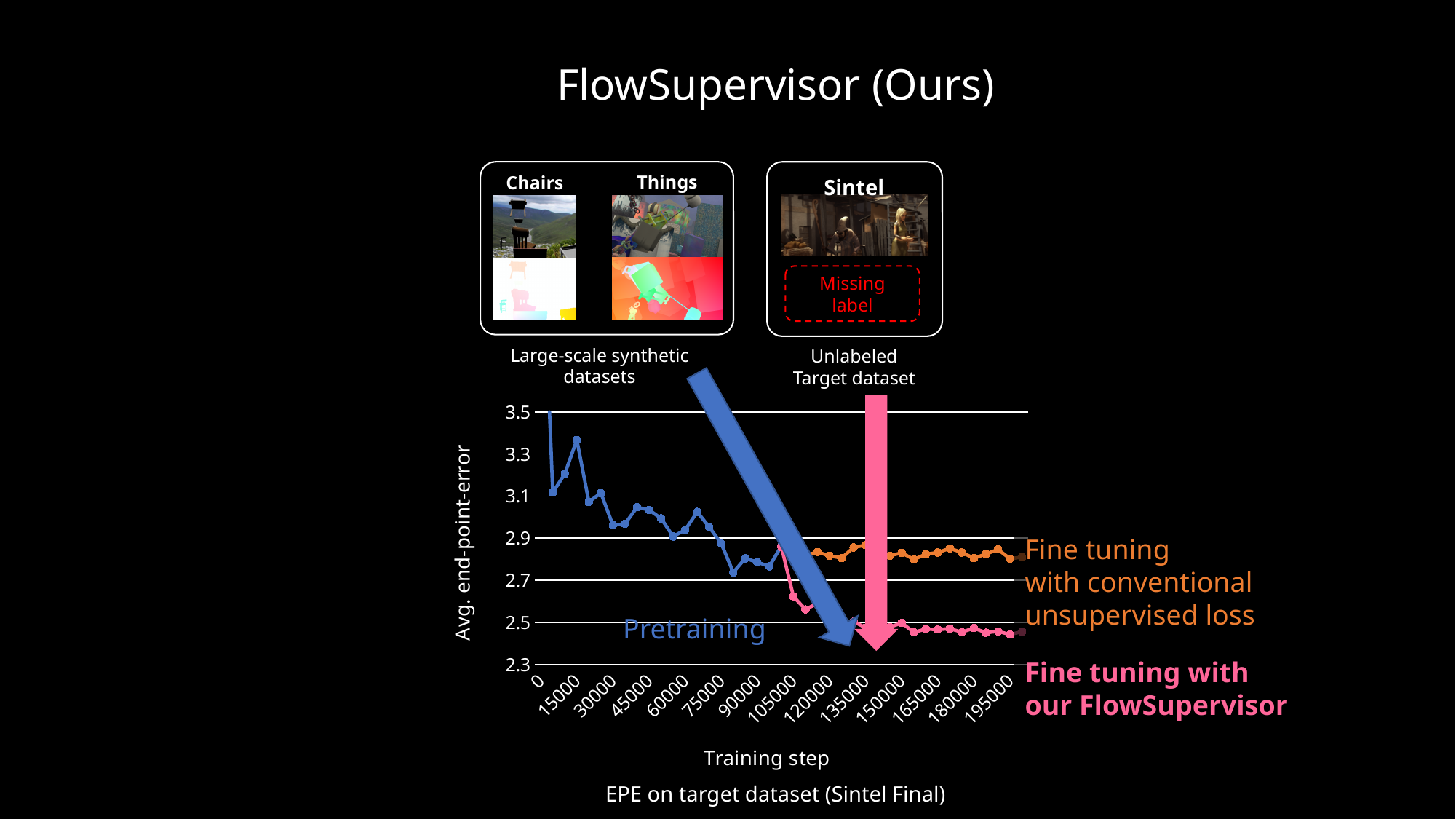
How many series are plotted in the chart? 3 Is the value of the Pretraining series at training step 90000 greater or less than 2.9? less What kind of chart is shown on the slide? line chart Is the value of the Pretraining series at training step 0 greater or less than 3.3? greater At training step 195000, which series has the larger value: 'Fine tuning with conventional unsupervised loss' or 'Fine tuning with our FlowSupervisor'? Fine tuning with conventional unsupervised loss What is the label of the x axis of the chart? Training step How many tick labels are shown on the x axis of the chart? 14 Is the value of the 'Fine tuning with our FlowSupervisor' series at training step 195000 greater or less than 2.5? less What is the highest value shown on the y axis of the chart? 3.5 Does the Pretraining series rise or fall as the training step increases? fall What is the label of the y axis of the chart? Avg. end-point-error